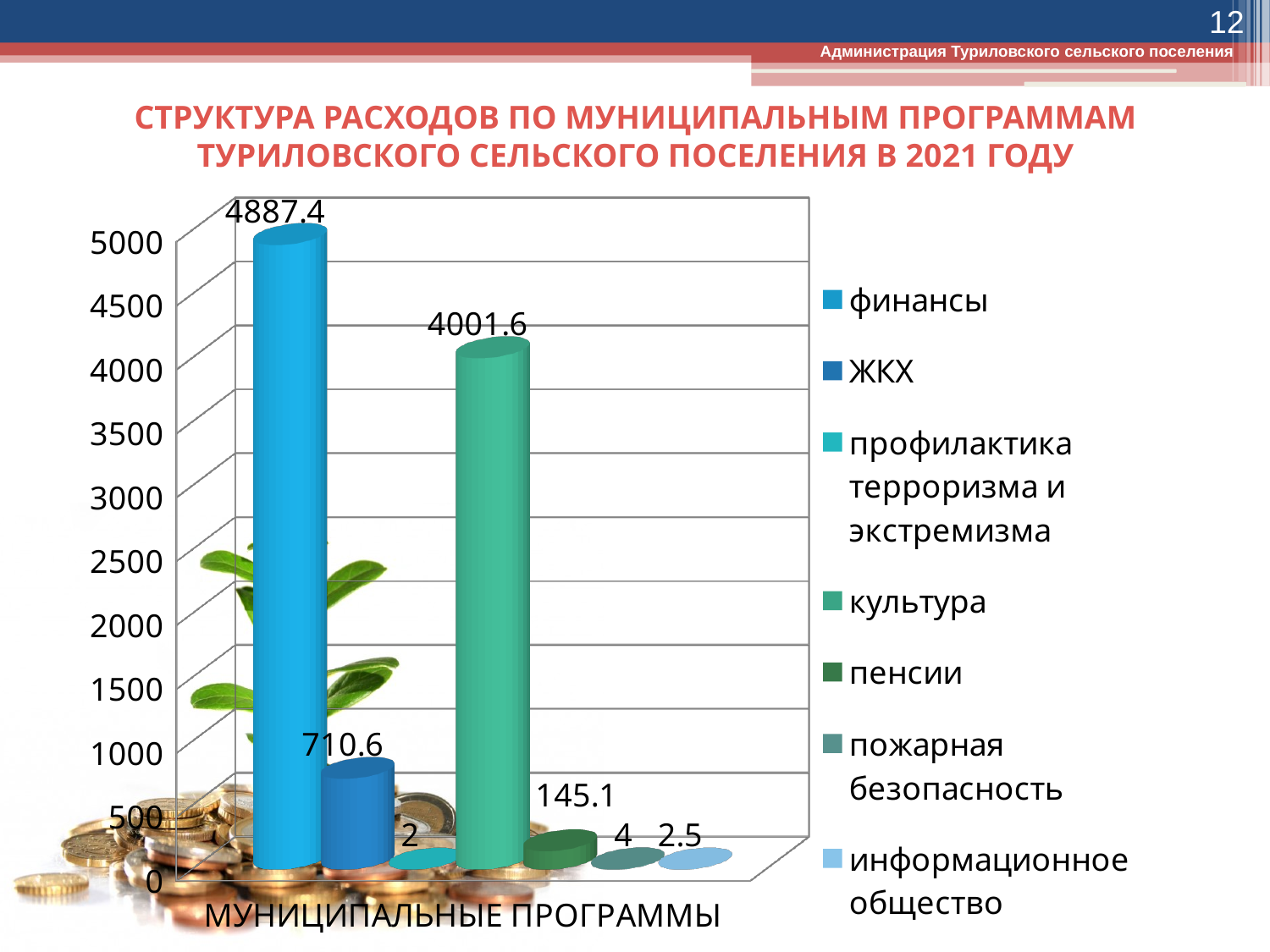
What is the value for информационное общество? 2.5 Which is larger, the value for ЖКХ or the value for пенсии? ЖКХ How many series does the legend list? 7 What is the value for ЖКХ? 710.6 What kind of chart is shown on the slide? bar chart What is the difference between the values for финансы and культура? 885.8 Which series has the lowest value? профилактика терроризма и экстремизма What is the value for финансы? 4887.4 Is the value for ЖКХ greater or less than 1000? less What is the value for культура? 4001.6 Which series has the highest value? финансы What is the value for пенсии? 145.1